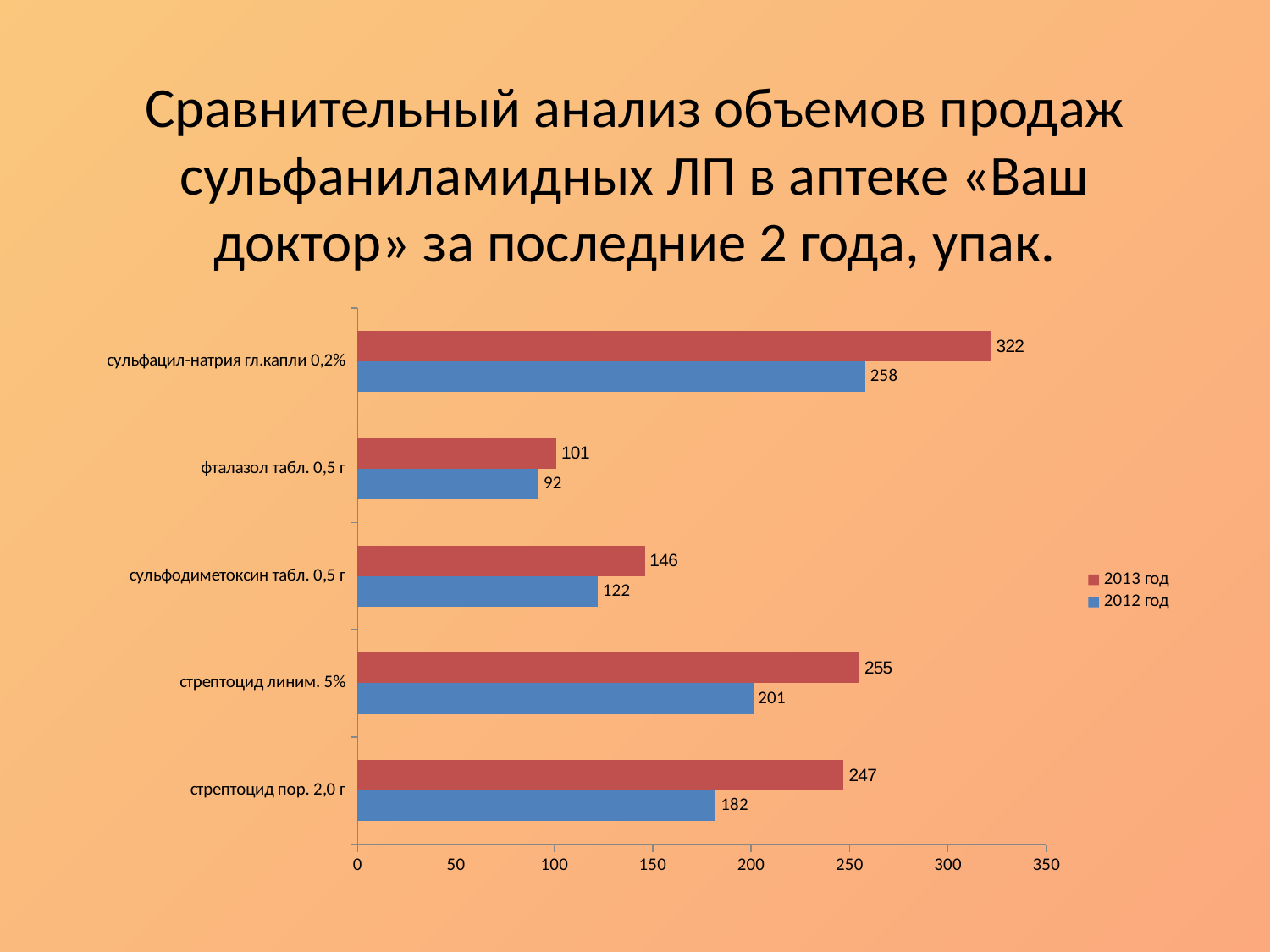
Which category has the lowest 2012 год value? фталазол табл. 0,5 г What is the 2012 год value for фталазол табл. 0,5 г? 92 How many series does the legend list? 2 Which colour represents 2012 год in the chart? blue What is the 2012 год value for стрептоцид пор. 2,0 г? 182 Which category has the highest 2013 год value? сульфацил-натрия гл.капли 0,2% Which is larger for стрептоцид линим. 5%: the 2013 год value or the 2012 год value? 2013 год What kind of chart is shown on the slide? bar chart How many categories are shown on the chart? 5 Is the 2012 год value for сульфодиметоксин табл. 0,5 г greater or less than 150? less What is the 2013 год value for сульфацил-натрия гл.капли 0,2%? 322 What is the difference between the 2013 год and 2012 год values for стрептоцид пор. 2,0 г? 65